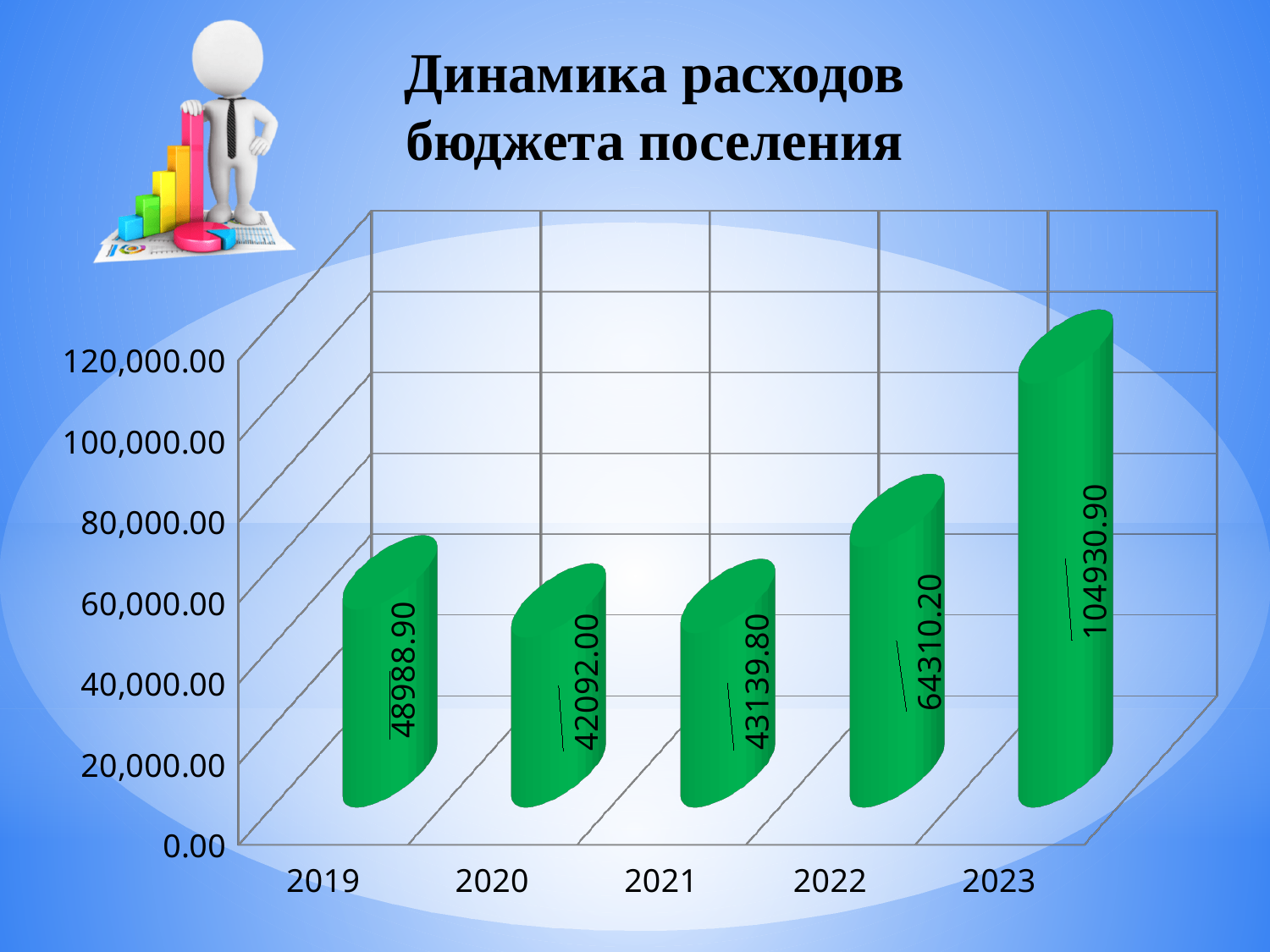
Is the value for 2023 greater or less than 100,000.00? greater Which year has the lowest value? 2020 Which year has the highest value? 2023 What is the value for 2022? 64310.20 What is the value for 2023? 104930.90 What is the difference between the values for 2019 and 2020? 6896.90 How many years are shown on the x axis? 5 What is the title of the chart? Динамика расходов бюджета поселения Which is larger, the value for 2021 or the value for 2020? 2021 What is the difference between the values for 2023 and 2022? 40620.70 What kind of chart is shown on the slide? bar chart What is the value for 2019? 48988.90